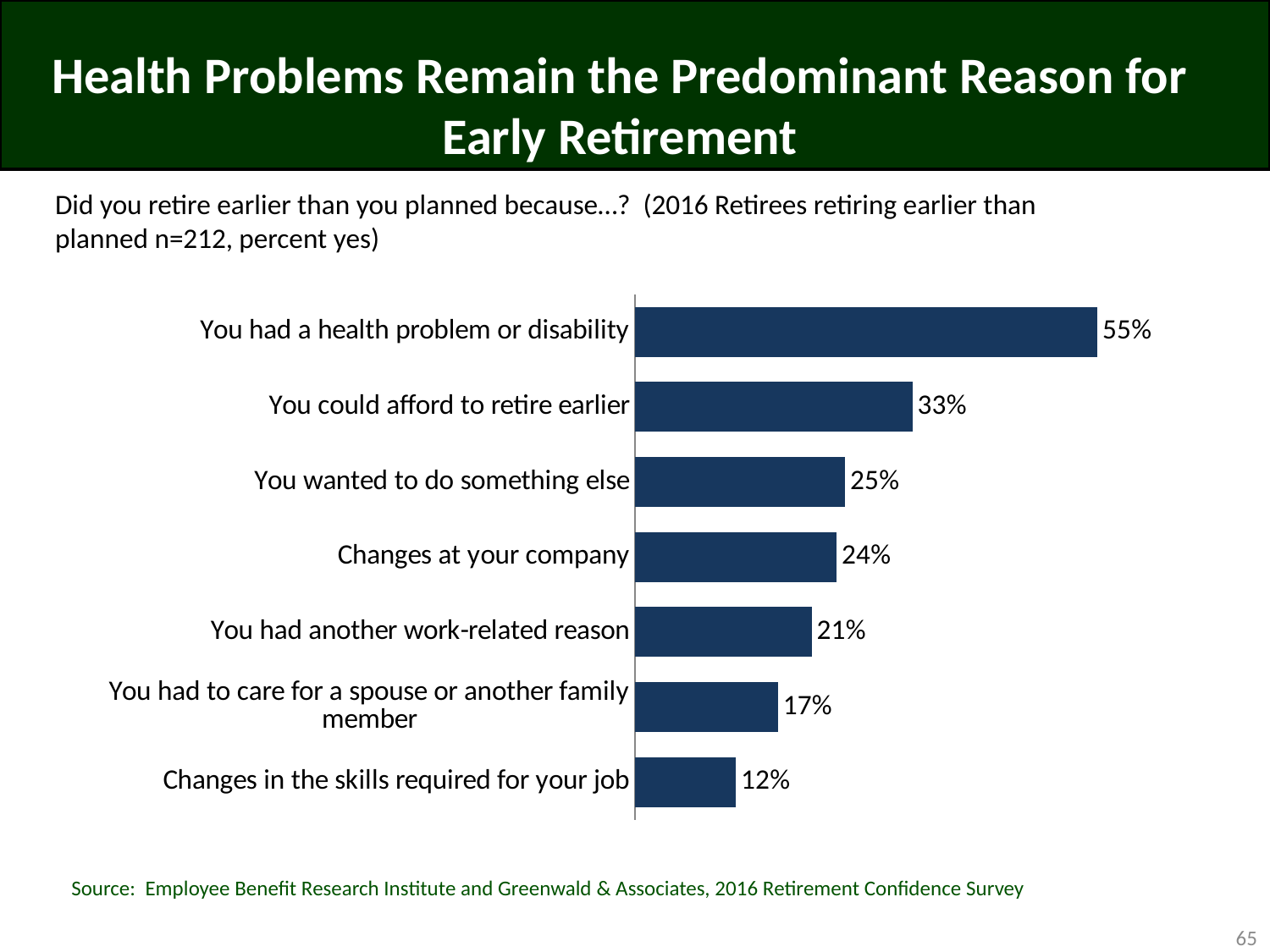
What is the value for 'You could afford to retire earlier'? 33% What is the sample size (n) of retirees retiring earlier than planned given on the slide? 212 What is the difference between the percentage for 'You had a health problem or disability' and 'You could afford to retire earlier'? 22 percentage points What is the value for 'You had to care for a spouse or another family member'? 17% Which reason for early retirement has the highest percentage? You had a health problem or disability What is the difference between 'You wanted to do something else' and 'Changes in the skills required for your job'? 13 percentage points What type of chart is shown on the slide? Bar chart How many reasons for early retirement are shown in the chart? 7 What percentage of retirees said they retired earlier than planned because they had a health problem or disability? 55% Which is larger: the value for 'You had another work-related reason' or 'You had to care for a spouse or another family member'? You had another work-related reason Which reason for early retirement has the lowest percentage? Changes in the skills required for your job What percentage cited 'Changes at your company' as a reason for retiring early? 24%